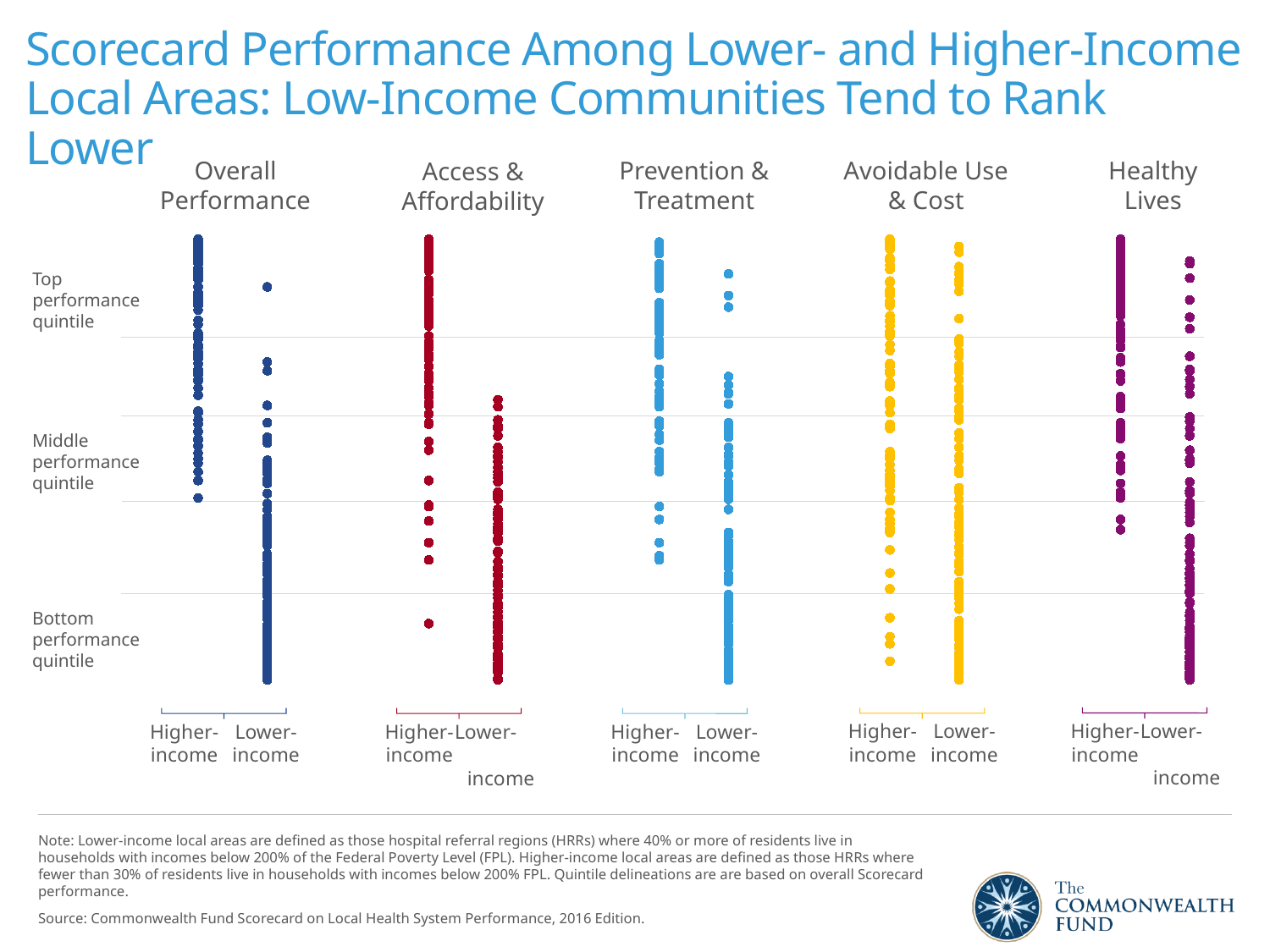
How many income groups are compared within each panel of the chart? 2 According to the slide title, which type of community tends to rank lower on the Scorecard? Low-income communities In the Access & Affordability panel, which income group has local areas in the top performance quintile? Higher-income Which panel of the chart is drawn in purple? Healthy Lives What are the three performance quintile labels on the vertical axis? Top performance quintile, Middle performance quintile, Bottom performance quintile In the Prevention & Treatment panel, which income group has local areas in the bottom performance quintile? Lower-income In the Overall Performance panel, which income group has local areas in the bottom performance quintile? Lower-income What kind of chart is shown on the slide? Dot plot (strip chart) How many performance dimensions (panels) are shown across the top of the chart? 5